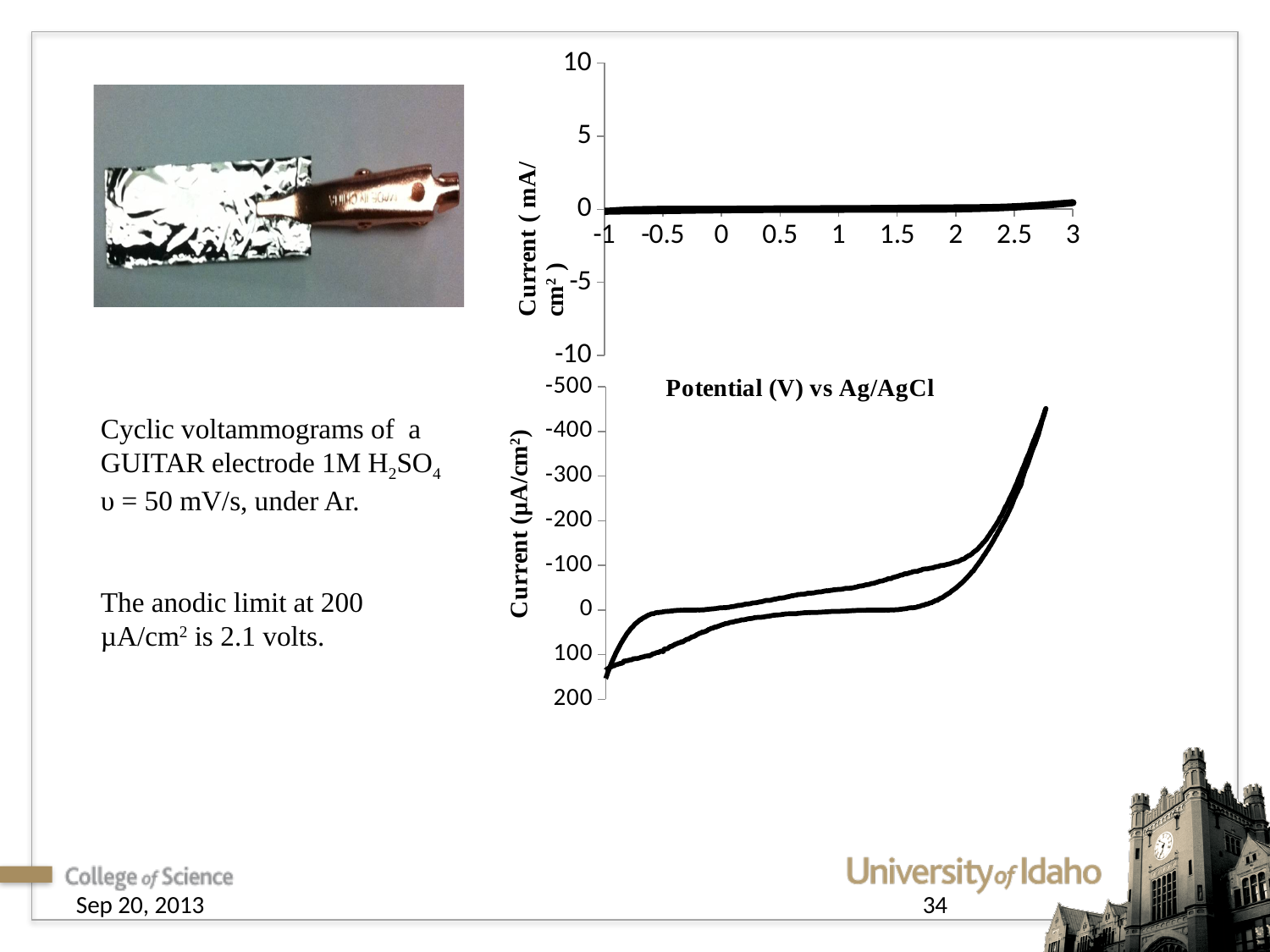
What kind of chart is the top chart on the slide? line chart What kind of chart is the bottom chart on the slide? line chart In the top chart, is the current at a potential of 0 V greater or less than 5 mA/cm²? less In the bottom chart, is the current at a potential of 1 V greater or less than -200 µA/cm²? greater In the top chart, does the current stay near 0 or change strongly as the potential goes from -1 V to 2 V? stays near 0 In the bottom chart, is the current at a potential of 3 V greater or less than -400 µA/cm²? less In the bottom chart, does the magnitude of the current increase or decrease as the potential goes from 2 V to 3 V? increase In the bottom chart, what is the label of the y axis? Current (µA/cm²)